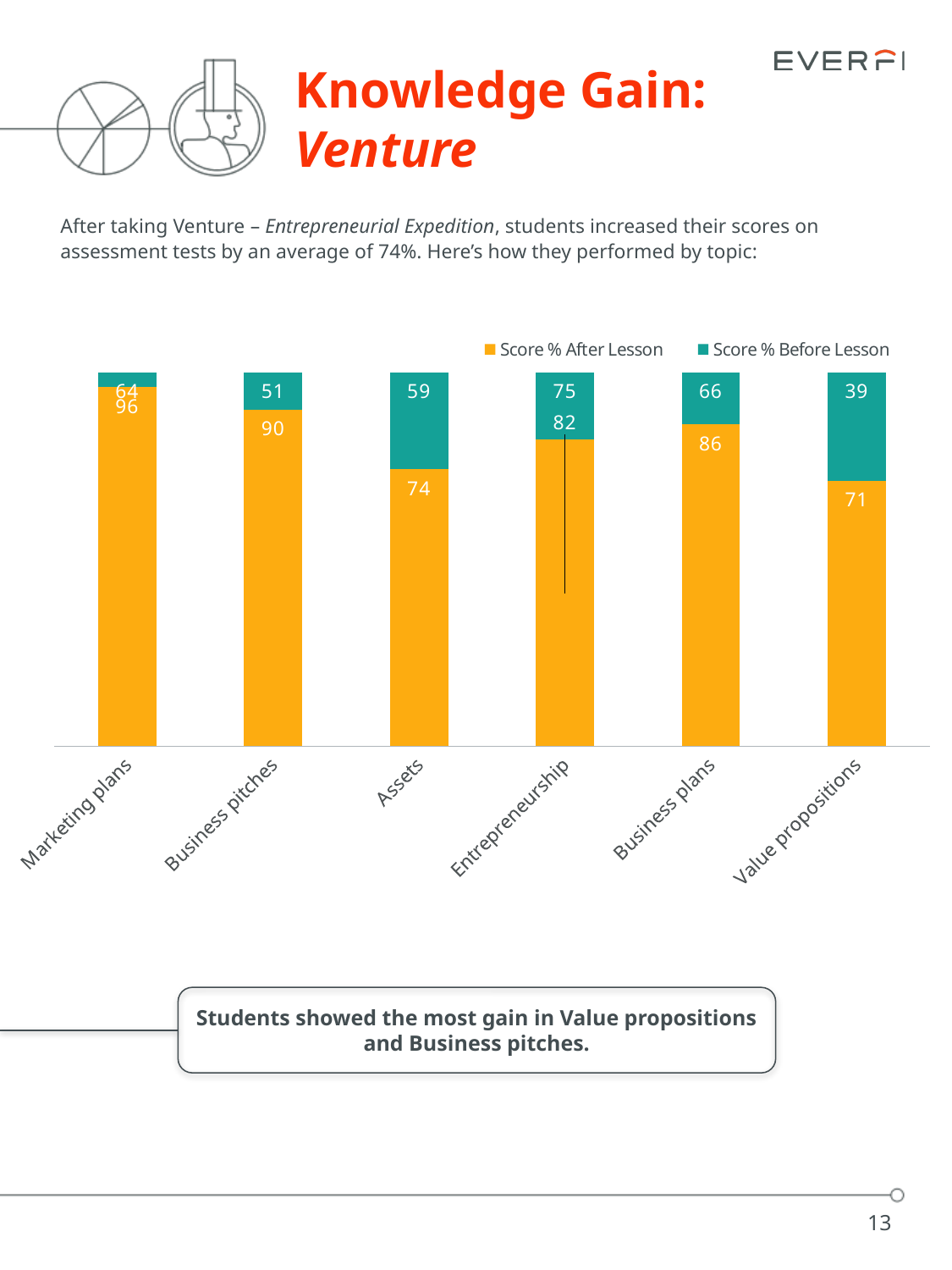
Which topic has the highest Score % After Lesson? Marketing plans How many series does the chart legend list? 2 What is the Score % Before Lesson for Business pitches? 51 What is the Score % Before Lesson for Value propositions? 39 What is the difference between the Score % After Lesson for Assets and the Score % After Lesson for Business plans? 12 What is the Score % After Lesson for Marketing plans? 96 How many topics are shown on the x axis of the chart? 6 Which is larger: the Score % Before Lesson for Entrepreneurship or the Score % Before Lesson for Business plans? Entrepreneurship What is the Score % After Lesson for Entrepreneurship? 82 What is the difference between the Score % After Lesson and the Score % Before Lesson for Business pitches? 39 Which topic has the lowest Score % Before Lesson? Value propositions What kind of chart is shown on the slide? Bar chart